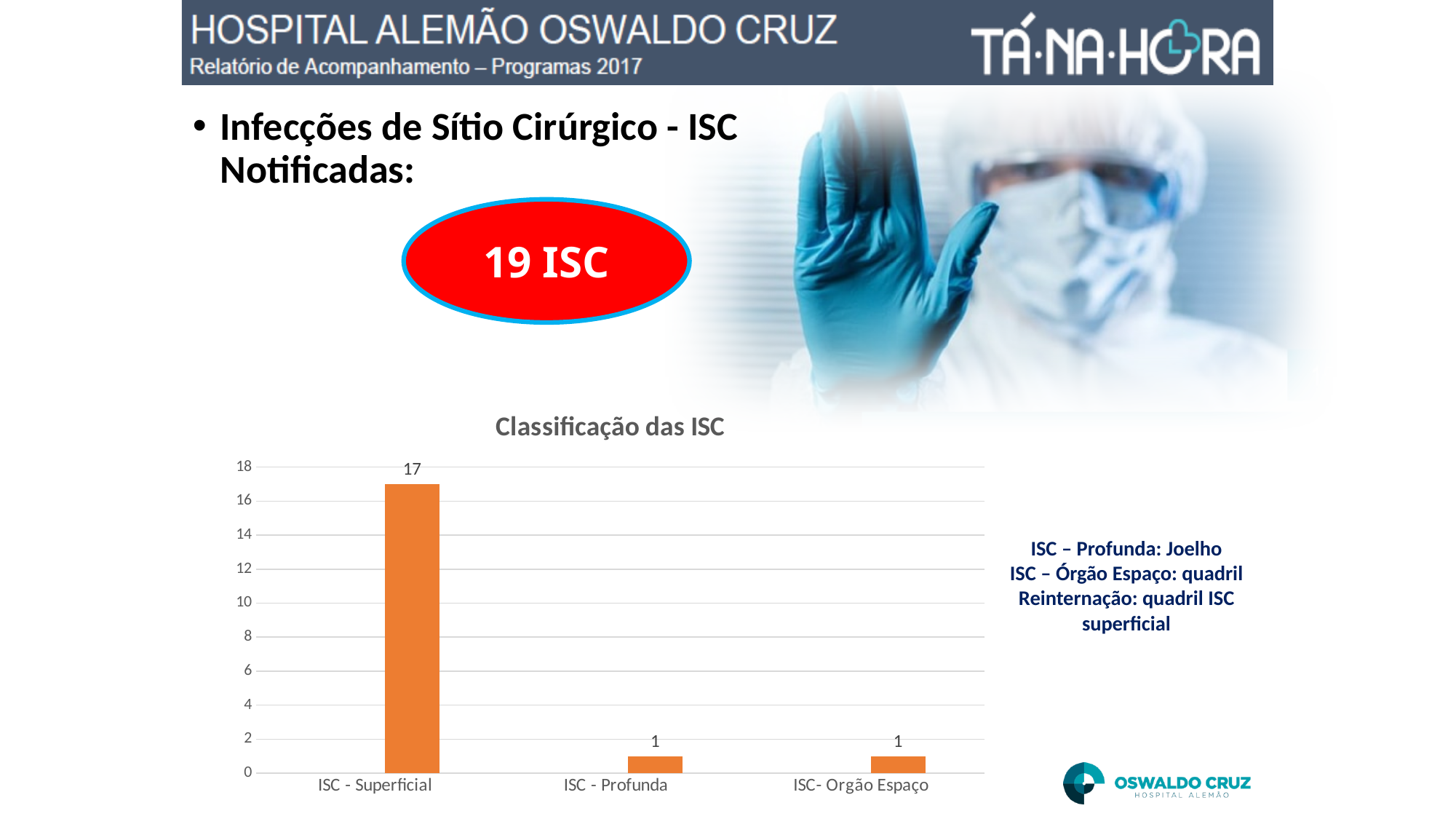
What is the total of the three values plotted in the chart? 19 What is the title of the chart? Classificação das ISC Is the value for ISC - Profunda greater or less than 4? less What is the value for ISC - Profunda? 1 What is the value for ISC- Orgão Espaço? 1 Is the value for ISC - Superficial greater or less than 10? greater What is the value for ISC - Superficial? 17 Which is larger, the value for ISC - Superficial or the value for ISC- Orgão Espaço? ISC - Superficial What kind of chart is shown on the slide? bar chart What is the difference between the values for ISC - Superficial and ISC - Profunda? 16 How many categories are shown on the x axis of the chart? 3 Which category has the highest value? ISC - Superficial